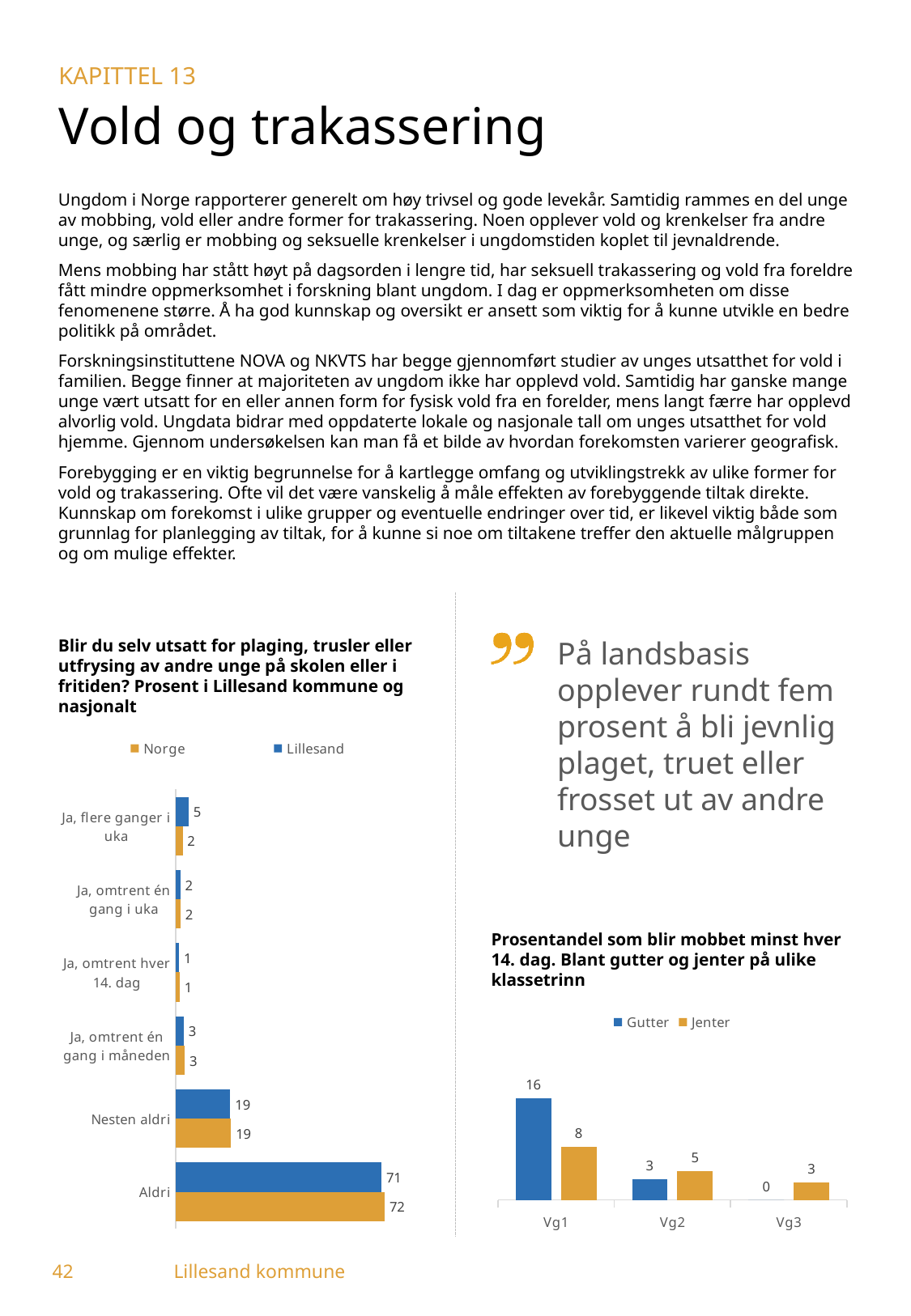
In the chart 'Blir du selv utsatt for plaging, trusler eller utfrysing av andre unge på skolen eller i fritiden?', how many categories are shown? 6 In the chart 'Blir du selv utsatt for plaging, trusler eller utfrysing av andre unge på skolen eller i fritiden?', what is the difference between the Lillesand and Norge values for 'Ja, flere ganger i uka'? 3 In the chart 'Blir du selv utsatt for plaging, trusler eller utfrysing av andre unge på skolen eller i fritiden?', what is the Lillesand value for 'Aldri'? 71 In the chart 'Blir du selv utsatt for plaging, trusler eller utfrysing av andre unge på skolen eller i fritiden?', what is the Norge value for 'Ja, flere ganger i uka'? 2 In the chart 'Blir du selv utsatt for plaging, trusler eller utfrysing av andre unge på skolen eller i fritiden?', which category has the lowest Norge value? Ja, omtrent hver 14. dag In the chart 'Blir du selv utsatt for plaging, trusler eller utfrysing av andre unge på skolen eller i fritiden?', which category has the highest Lillesand value? Aldri In the chart 'Blir du selv utsatt for plaging, trusler eller utfrysing av andre unge på skolen eller i fritiden?', how many series does the legend list? 2 What kind of chart is 'Prosentandel som blir mobbet minst hver 14. dag'? Bar chart In the chart 'Prosentandel som blir mobbet minst hver 14. dag', what is the Jenter value for Vg3? 3 In the chart 'Prosentandel som blir mobbet minst hver 14. dag', what is the Gutter value for Vg1? 16 In the chart 'Prosentandel som blir mobbet minst hver 14. dag', which is larger for Vg2, Gutter or Jenter? Jenter In the chart 'Prosentandel som blir mobbet minst hver 14. dag', what is the difference between Gutter and Jenter for Vg1? 8